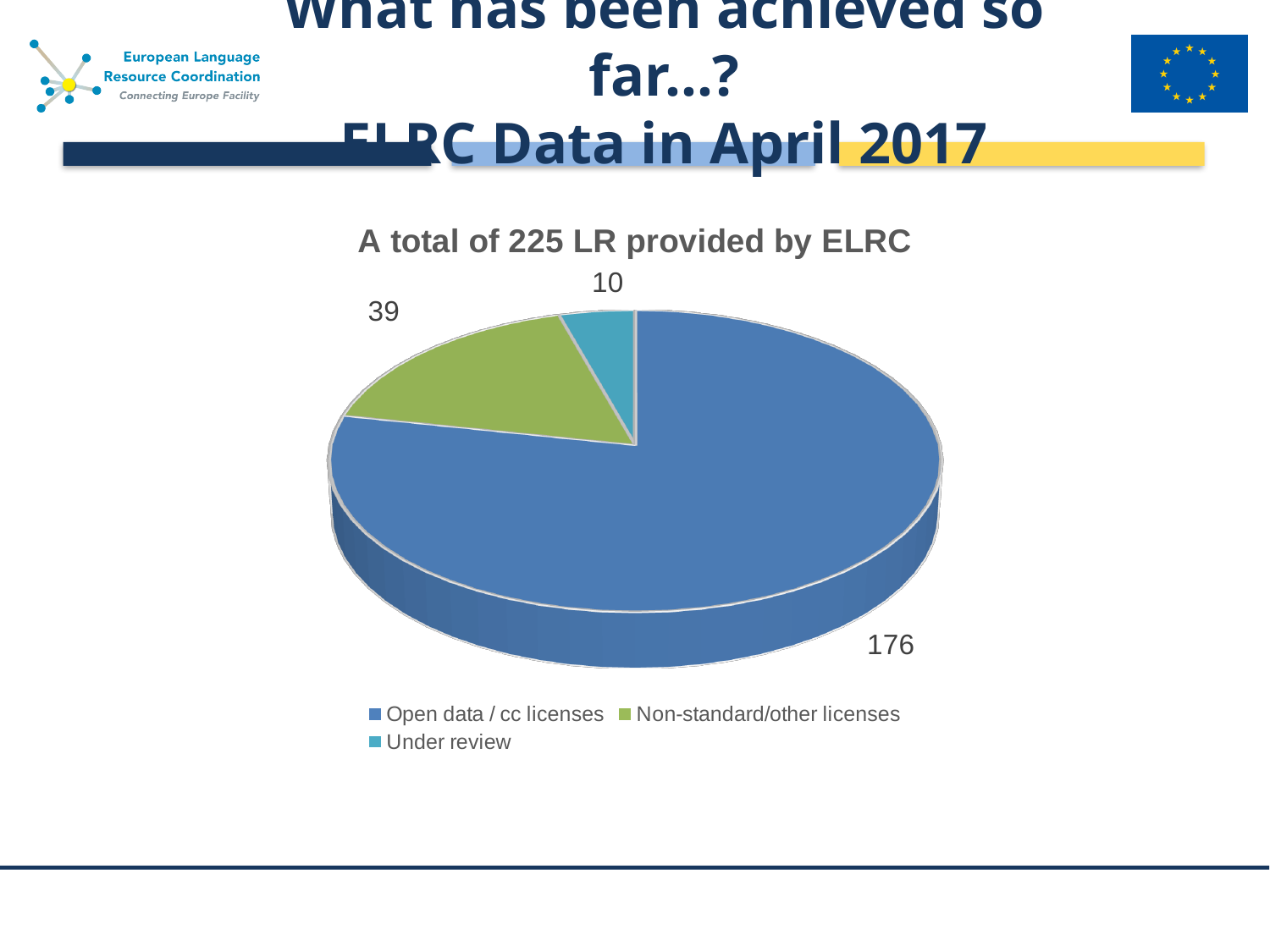
Which category has the smallest slice? Under review How many categories does the pie chart show? 3 Which is larger, Non-standard/other licenses or Under review? Non-standard/other licenses What kind of chart is shown on the slide? Pie chart What is the difference between the values for Non-standard/other licenses and Under review? 29 What is the value for Non-standard/other licenses? 39 What is the value for Open data / cc licenses? 176 What is the value for Under review? 10 What is the title of the chart? A total of 225 LR provided by ELRC Which category has the largest slice? Open data / cc licenses What is the difference between the values for Open data / cc licenses and Non-standard/other licenses? 137 What is the total of all slices in the pie chart? 225